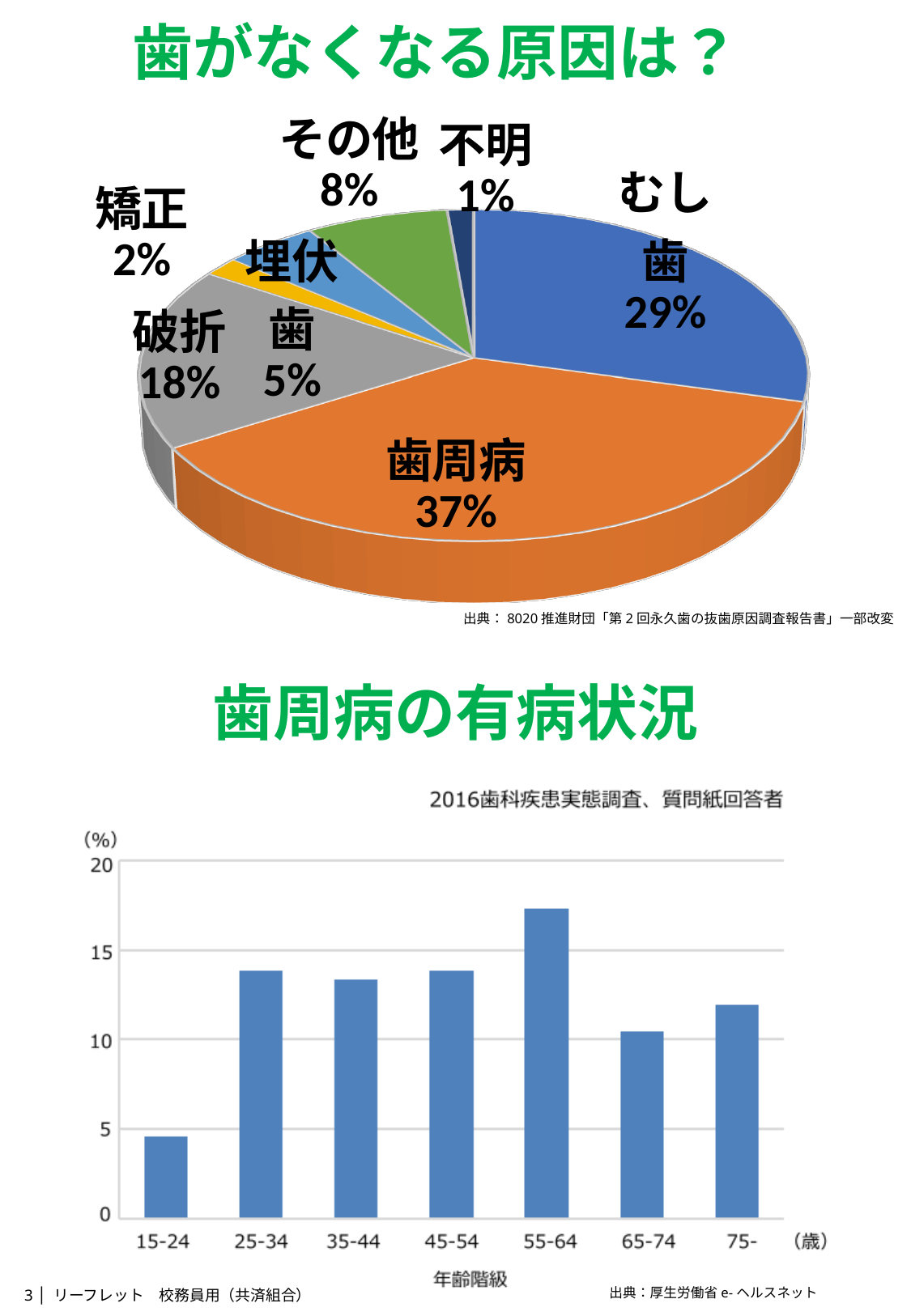
In the bar chart titled 歯周病の有病状況, which age group has the lowest value? 15-24 In the pie chart titled 歯がなくなる原因は？, what is the difference in percentage points between 歯周病 and むし歯? 8 In the pie chart titled 歯がなくなる原因は？, which cause has the largest share? 歯周病 In the pie chart titled 歯がなくなる原因は？, which is larger, その他 or 埋伏歯? その他 In the bar chart titled 歯周病の有病状況, is the value for 15-24 greater or less than 5? less In the bar chart titled 歯周病の有病状況, which age group has the highest value? 55-64 In the pie chart titled 歯がなくなる原因は？, what percentage is shown for むし歯? 29% In the pie chart titled 歯がなくなる原因は？, how many slices are there? 7 In the pie chart titled 歯がなくなる原因は？, which cause has the smallest share? 不明 In the pie chart titled 歯がなくなる原因は？, what percentage is shown for 歯周病? 37% What kind of chart is the top chart titled 歯がなくなる原因は？? Pie chart In the pie chart titled 歯がなくなる原因は？, what percentage is shown for 破折? 18%